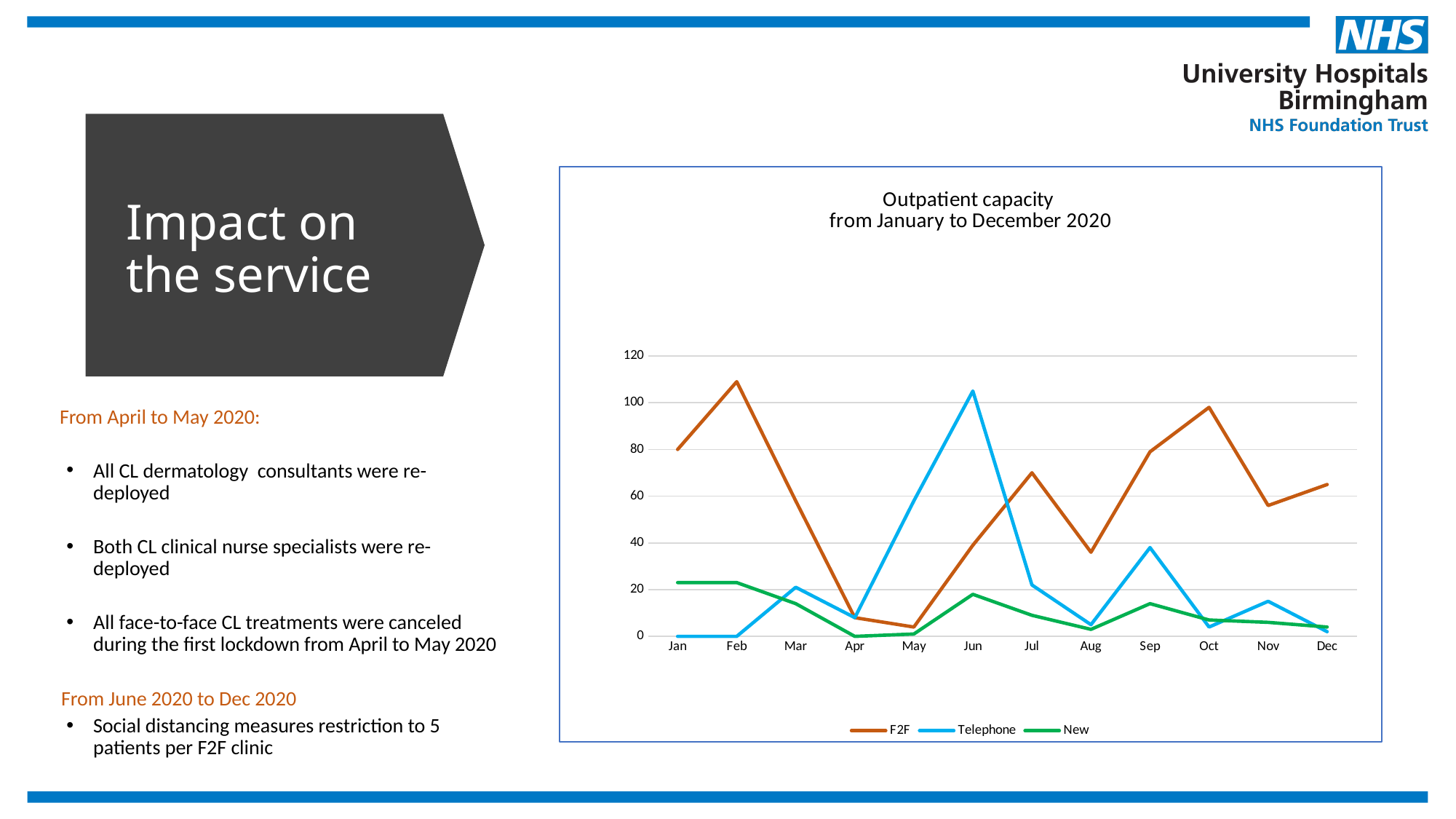
What is the Telephone value for Jan? 0 Does the F2F series rise or fall from Feb to Apr? fall What kind of chart is shown on the slide? line chart In Jun, which series has the larger value, F2F or Telephone? Telephone Is the Telephone value for Jun greater or less than 100? greater Is the F2F value for Feb greater or less than 100? greater In which month does the Telephone series reach its highest value? Jun In Oct, which series has the larger value, F2F or Telephone? F2F Is the New value for Jan greater or less than 40? less How many series does the legend of the chart list? 3 How many months are plotted along the x axis of the chart? 12 In which month does the F2F series reach its highest value? Feb